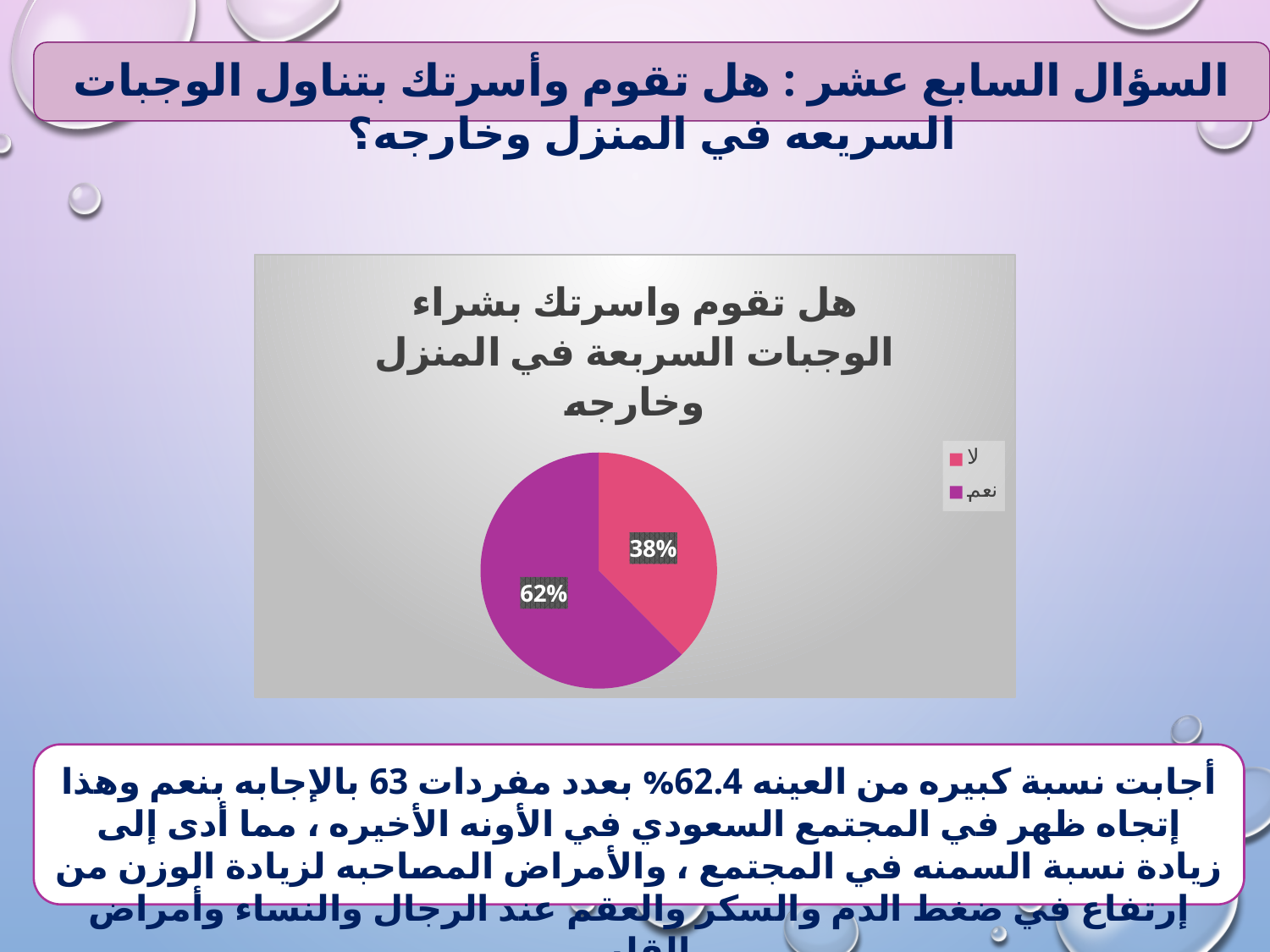
What kind of chart is shown on the slide? pie chart What percentage of the pie is labelled for the "نعم" slice? 62% What is the difference in percentage points between the "نعم" slice and the "لا" slice? 24 What share of the pie does the "لا" slice represent? 38% Which slice of the pie chart is the largest? نعم What colour is the "لا" slice in the pie chart? pink What percentage of the pie is labelled for the "لا" slice? 38% How many slices does the pie chart have? 2 How many entries does the chart legend list? 2 Which slice of the pie chart is the smallest? لا What colour is the "نعم" slice in the pie chart? purple Which is larger, the "نعم" slice or the "لا" slice? نعم